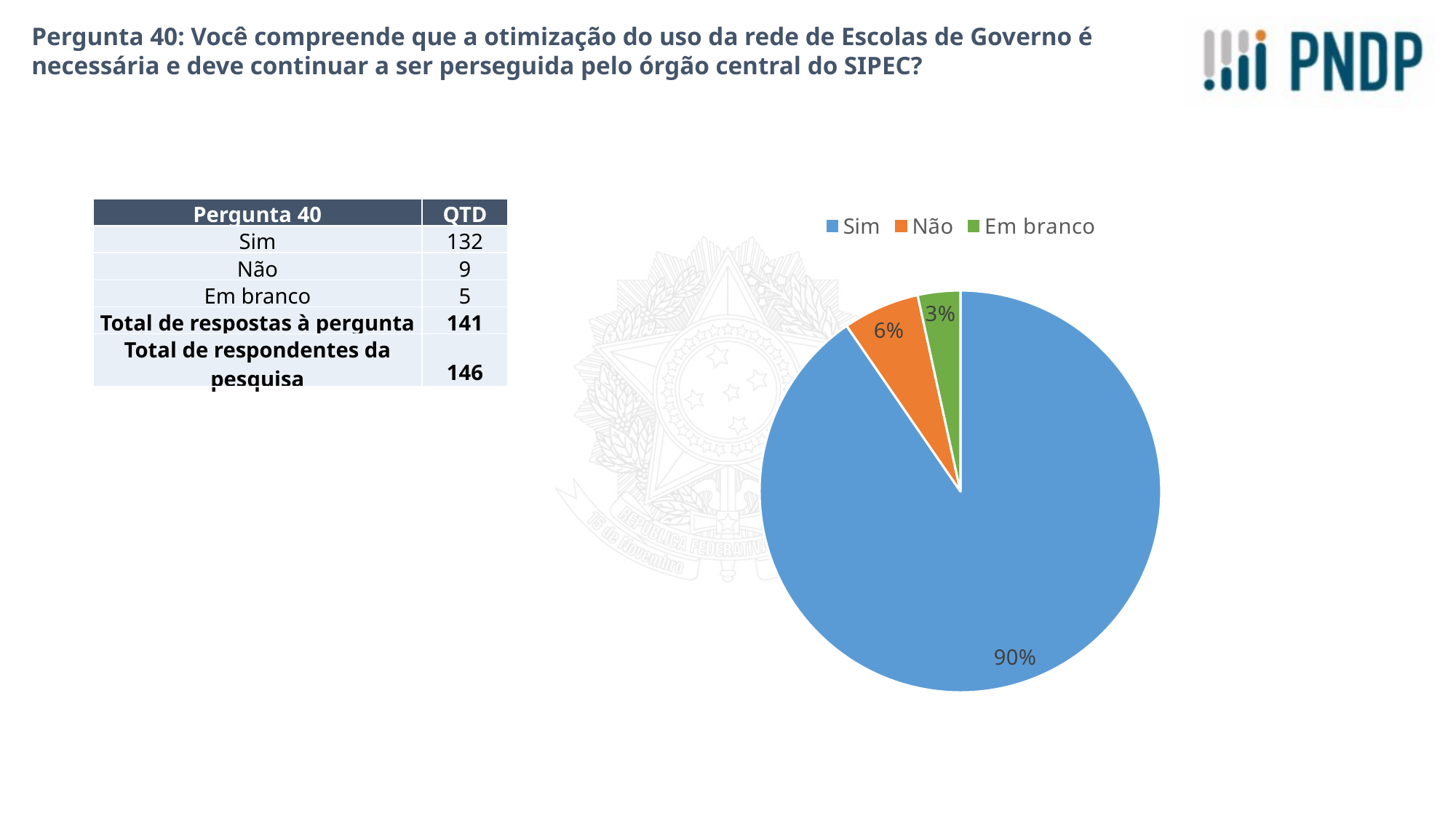
What is the difference in percentage points between the Sim slice and the Não slice? 84% What kind of chart is shown on the slide? pie chart Which category has the smallest slice of the pie? Em branco What share of the pie does the Sim slice represent? 90% What colour is the Sim slice in the pie chart? blue How many slices does the pie chart have? 3 Which category has the largest slice of the pie? Sim What colour is the Em branco slice in the pie chart? green What share of the pie does the Não slice represent? 6% What share of the pie does the Em branco slice represent? 3% Which slice is larger, Não or Em branco? Não How many entries does the legend list? 3